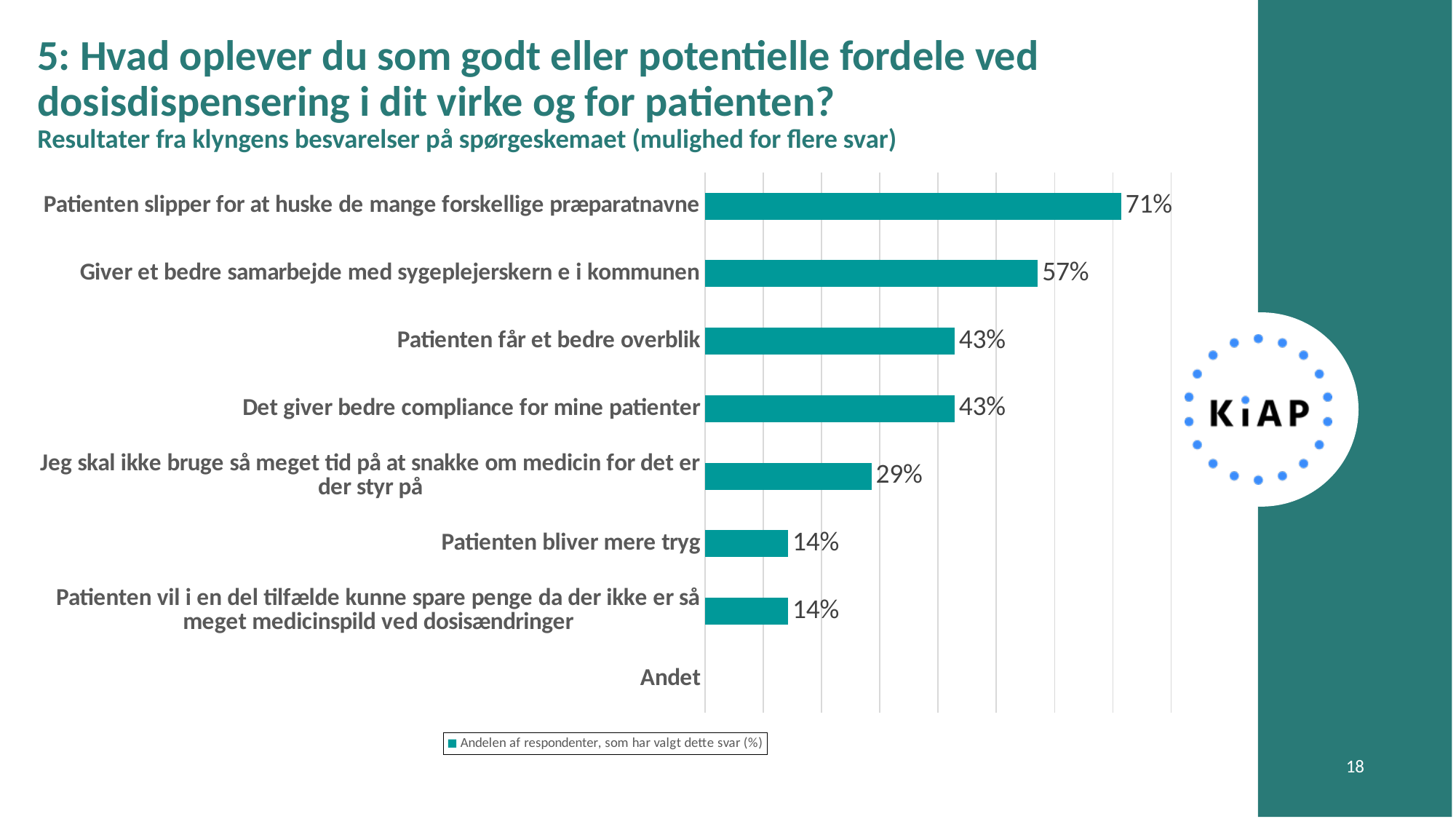
What value is shown for "Giver et bedre samarbejde med sygeplejerskern e i kommunen"? 57% Which is larger: the value for "Det giver bedre compliance for mine patienter" or the value for "Jeg skal ikke bruge så meget tid på at snakke om medicin for det er der styr på"? Det giver bedre compliance for mine patienter Which category has the highest value? Patienten slipper for at huske de mange forskellige præparatnavne What value is shown for "Patienten bliver mere tryg"? 14% What value is shown for "Jeg skal ikke bruge så meget tid på at snakke om medicin for det er der styr på"? 29% What is the legend entry shown below the chart? Andelen af respondenter, som har valgt dette svar (%) What kind of chart is shown on the slide? Bar chart What is the difference between the values for "Patienten slipper for at huske de mange forskellige præparatnavne" and "Giver et bedre samarbejde med sygeplejerskern e i kommunen"? 14% How many categories are listed on the chart's axis? 8 What is the difference between the values for "Patienten får et bedre overblik" and "Patienten bliver mere tryg"? 29% What value is shown for "Patienten slipper for at huske de mange forskellige præparatnavne"? 71% How many series does the legend list? 1